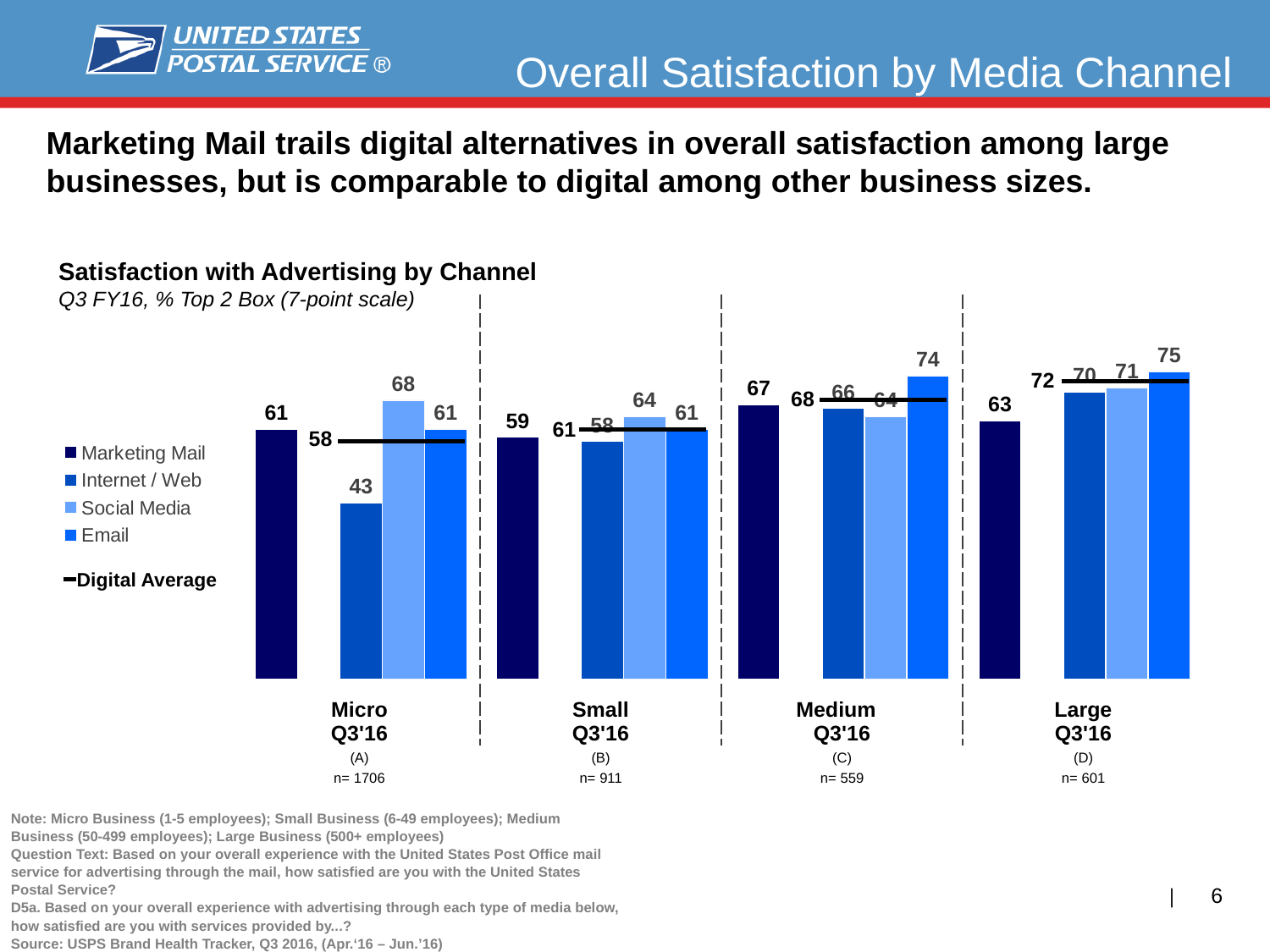
What is the Internet / Web satisfaction value for Micro businesses? 43 For Large businesses, how much higher is the Email value than the Marketing Mail value? 12 How many business size groups are shown on the x axis? 4 What is the Email satisfaction value for Large businesses (Q3'16)? 75 What is the Social Media satisfaction value for Small businesses? 64 What is the Digital Average value shown for Large businesses? 72 How many entries does the legend list? 5 Is the Marketing Mail value higher for Micro businesses or for Small businesses? Micro What type of chart is used to show satisfaction by channel? Bar chart What is the Marketing Mail satisfaction value for Micro businesses (Q3'16)? 61 Which channel has the highest satisfaction among Medium businesses? Email Which channel has the lowest satisfaction among Micro businesses? Internet / Web